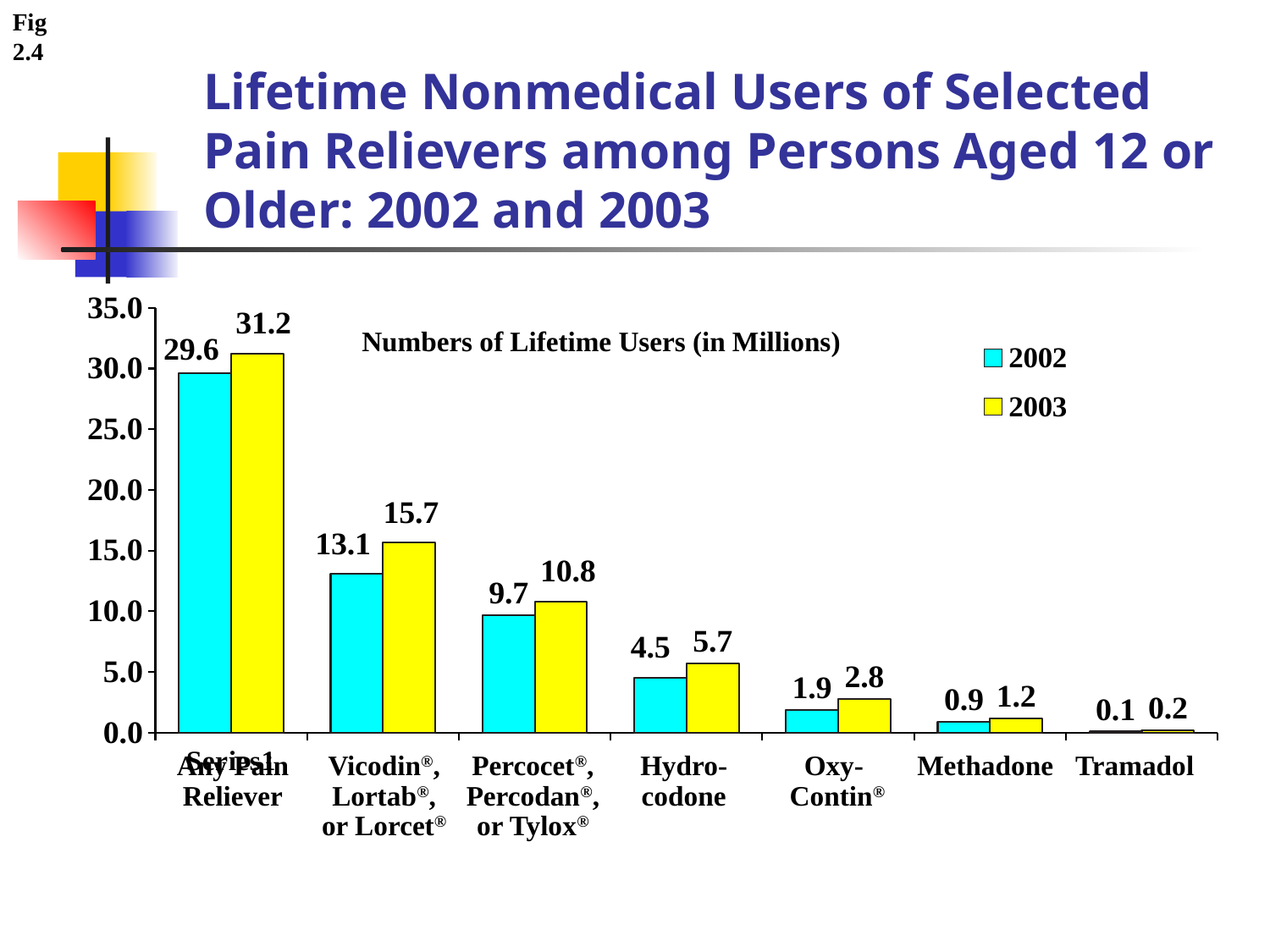
How many pain reliever categories are shown on the x axis? 7 What kind of chart is shown on the slide? bar chart Is the 2003 value for Vicodin, Lortab, or Lorcet greater or less than 15.0? greater What is the value for Any Pain Reliever in 2003? 31.2 How many series does the legend list? 2 Which category has the lowest 2002 value? Tramadol What is the difference between the 2002 values for Percocet, Percodan, or Tylox and OxyContin? 7.8 What is the 2003 value for Methadone? 1.2 Which is larger: the 2003 value for Hydrocodone or the 2002 value for Percocet, Percodan, or Tylox? 2002 value for Percocet, Percodan, or Tylox What is the difference between the 2003 and 2002 values for Vicodin, Lortab, or Lorcet? 2.6 What is the value for Hydrocodone in 2002? 4.5 Which category has the highest 2003 value? Any Pain Reliever